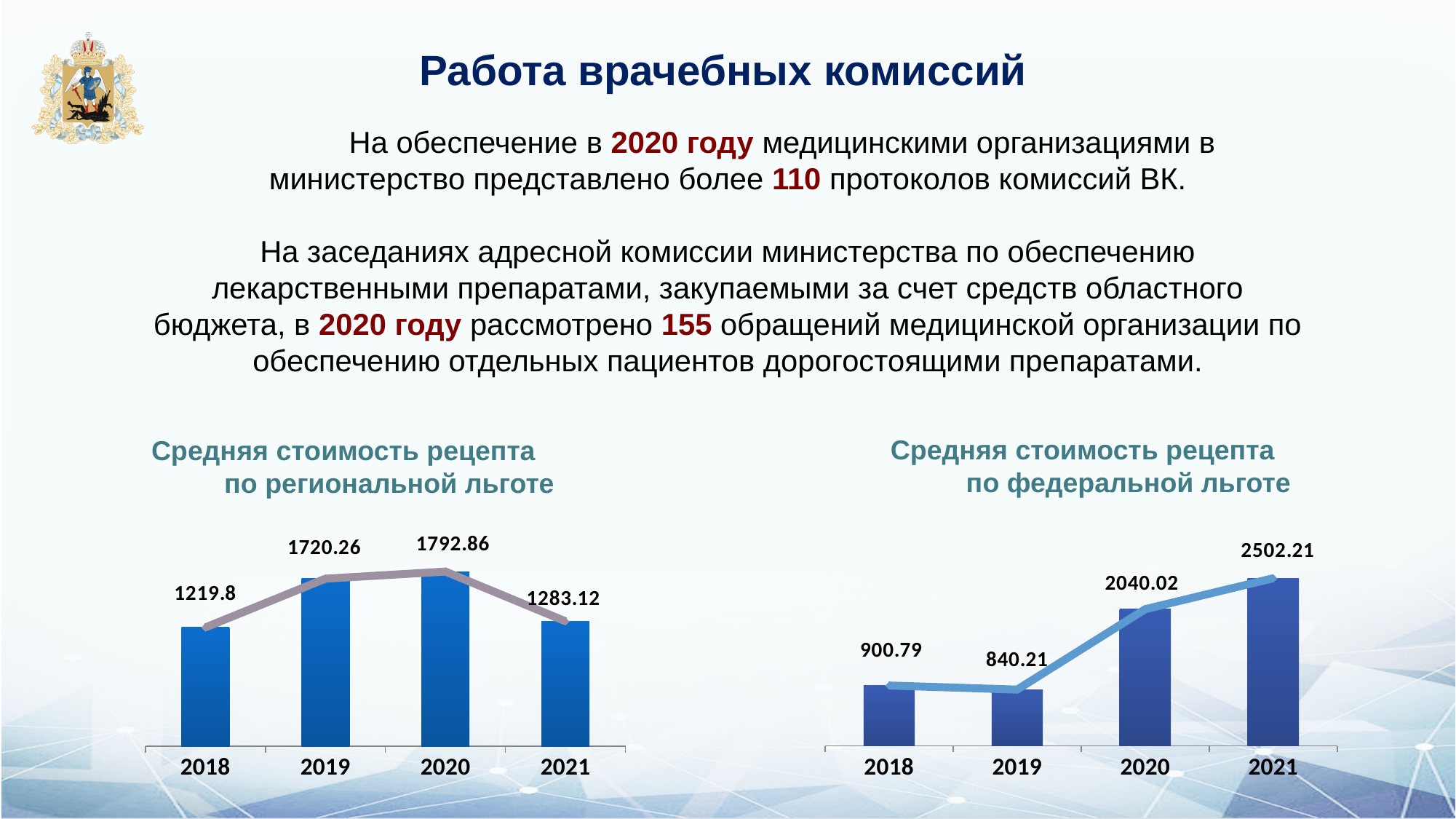
How many years are shown on the x axis of the chart 'Средняя стоимость рецепта по федеральной льготе'? 4 In the chart 'Средняя стоимость рецепта по региональной льготе', which is larger: the value for 2018 or the value for 2021? 2021 What kind of chart is 'Средняя стоимость рецепта по региональной льготе'? Bar chart with a line overlay In the chart 'Средняя стоимость рецепта по федеральной льготе', what is the difference between the values for 2021 and 2020? 462.19 In the chart 'Средняя стоимость рецепта по федеральной льготе', which year has the highest value? 2021 In the chart 'Средняя стоимость рецепта по федеральной льготе', which year has the lowest value? 2019 In the chart 'Средняя стоимость рецепта по региональной льготе', which year has the highest value? 2020 In the chart 'Средняя стоимость рецепта по региональной льготе', which year has the lowest value? 2018 In the chart 'Средняя стоимость рецепта по региональной льготе', what is the value for 2019? 1720.26 In the chart 'Средняя стоимость рецепта по региональной льготе', what is the value for 2021? 1283.12 In the chart 'Средняя стоимость рецепта по федеральной льготе', what is the value for 2020? 2040.02 In the chart 'Средняя стоимость рецепта по федеральной льготе', what is the value for 2018? 900.79